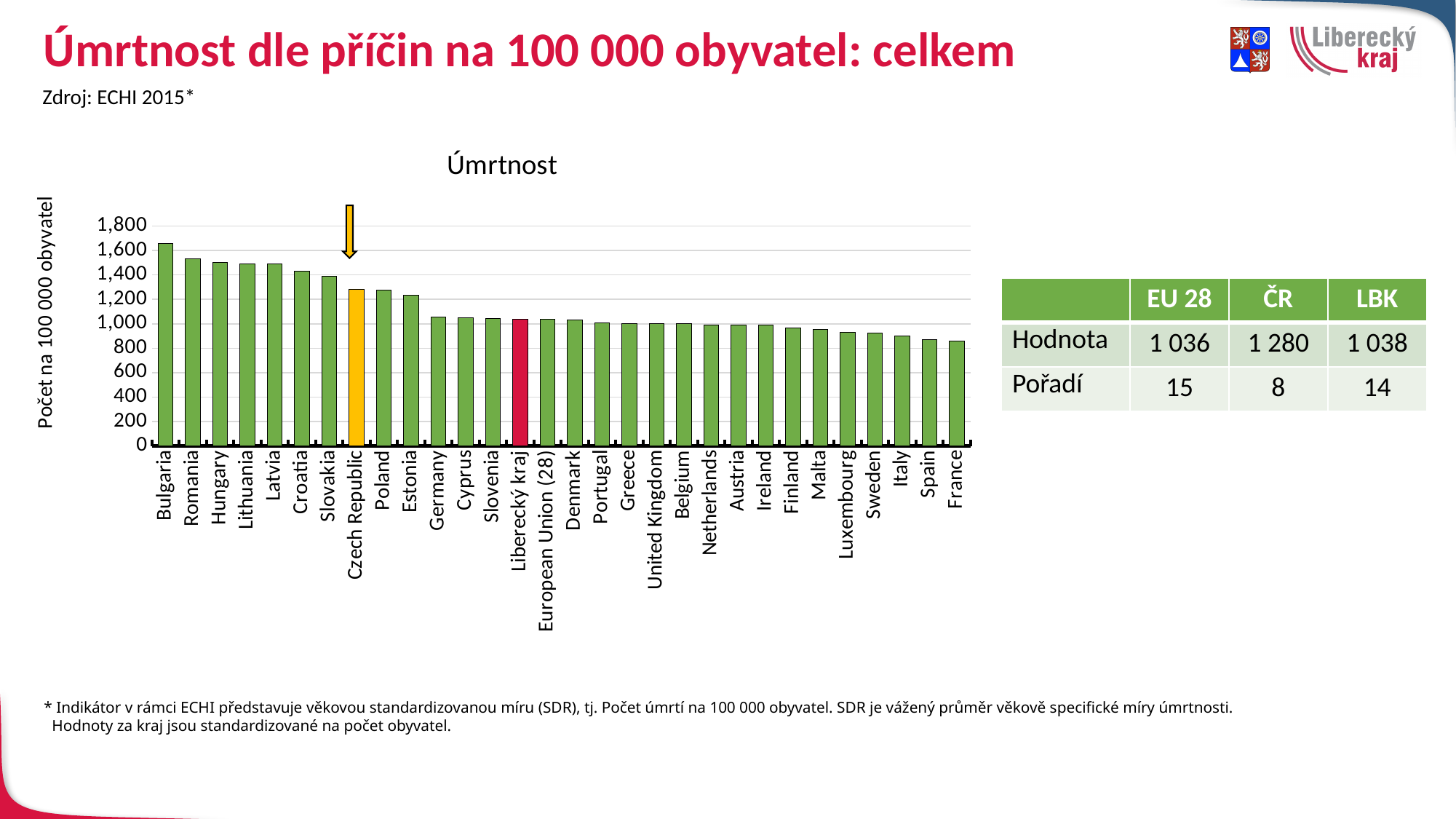
How many countries/regions are plotted on the x axis of the chart? 30 What type of chart is shown on the slide? bar chart According to the table, what is the value (Hodnota) for LBK? 1 038 Which category has the lowest mortality value in the chart? France According to the table, what is the value (Hodnota) for ČR? 1 280 According to the table, what is the rank (Pořadí) of EU 28? 15 What is the title of the chart? Úmrtnost Do the values rise or fall moving from left to right along the x axis? fall Which category has the highest mortality value in the chart? Bulgaria Is the value for Bulgaria greater or less than 1,400? greater Is the value for France greater or less than 1,000? less What is the difference between the ČR value and the LBK value shown in the table? 242